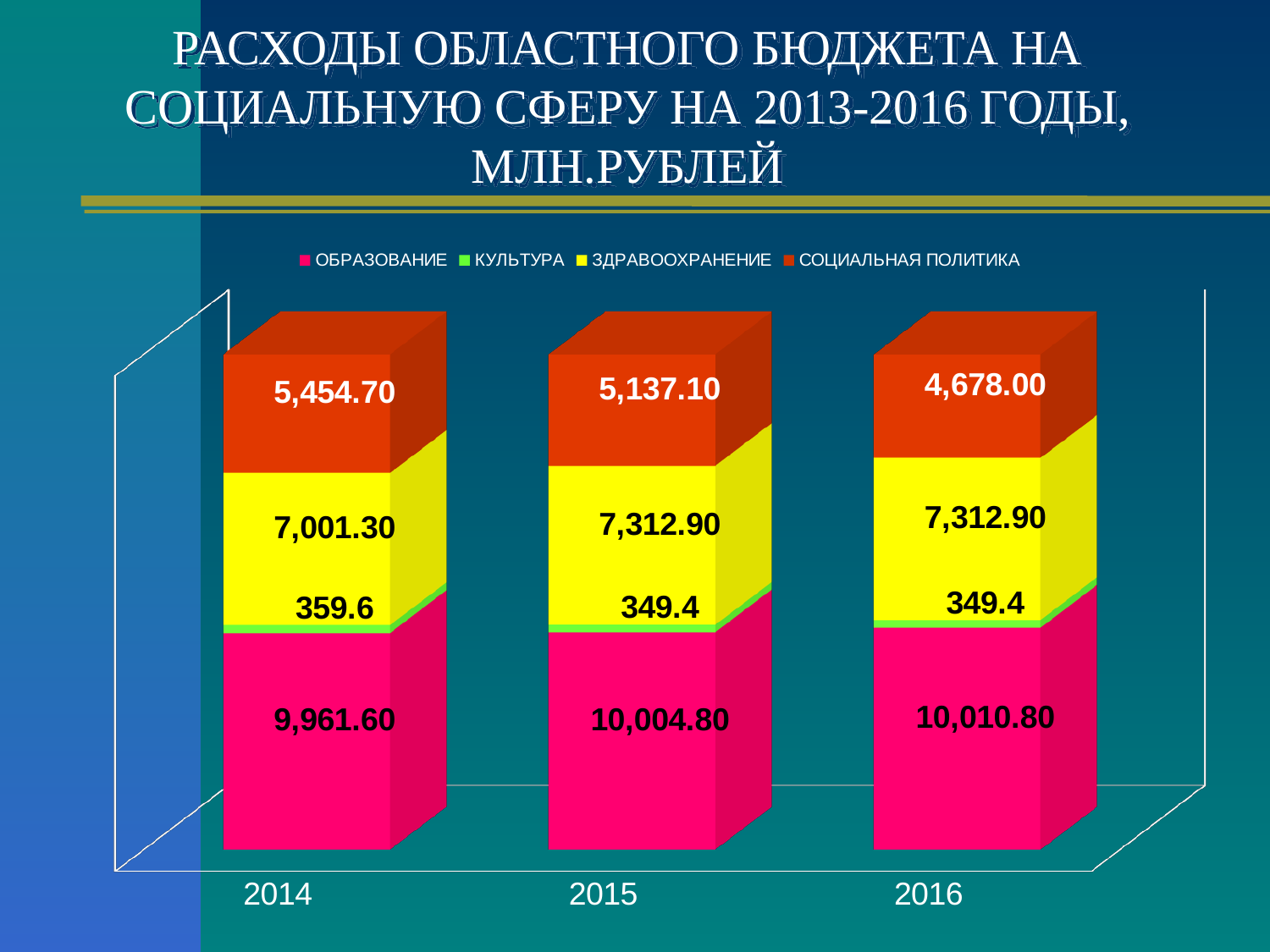
What is the difference between the СОЦИАЛЬНАЯ ПОЛИТИКА values for 2014 and 2016? 776.70 What is the value for СОЦИАЛЬНАЯ ПОЛИТИКА in 2016? 4,678.00 In which year is the value for ОБРАЗОВАНИЕ the lowest? 2014 What kind of chart is shown on the slide? Stacked bar chart In which year is the value for СОЦИАЛЬНАЯ ПОЛИТИКА the highest? 2014 How many series does the legend list? 4 What is the value for ЗДРАВООХРАНЕНИЕ in 2015? 7,312.90 Which is larger: ЗДРАВООХРАНЕНИЕ in 2014 or ЗДРАВООХРАНЕНИЕ in 2015? 2015 What is the value for КУЛЬТУРА in 2014? 359.6 What is the total of the stacked bar for 2016? 22,351.10 How many years are shown on the x axis? 3 What is the value for ОБРАЗОВАНИЕ in 2014? 9,961.60